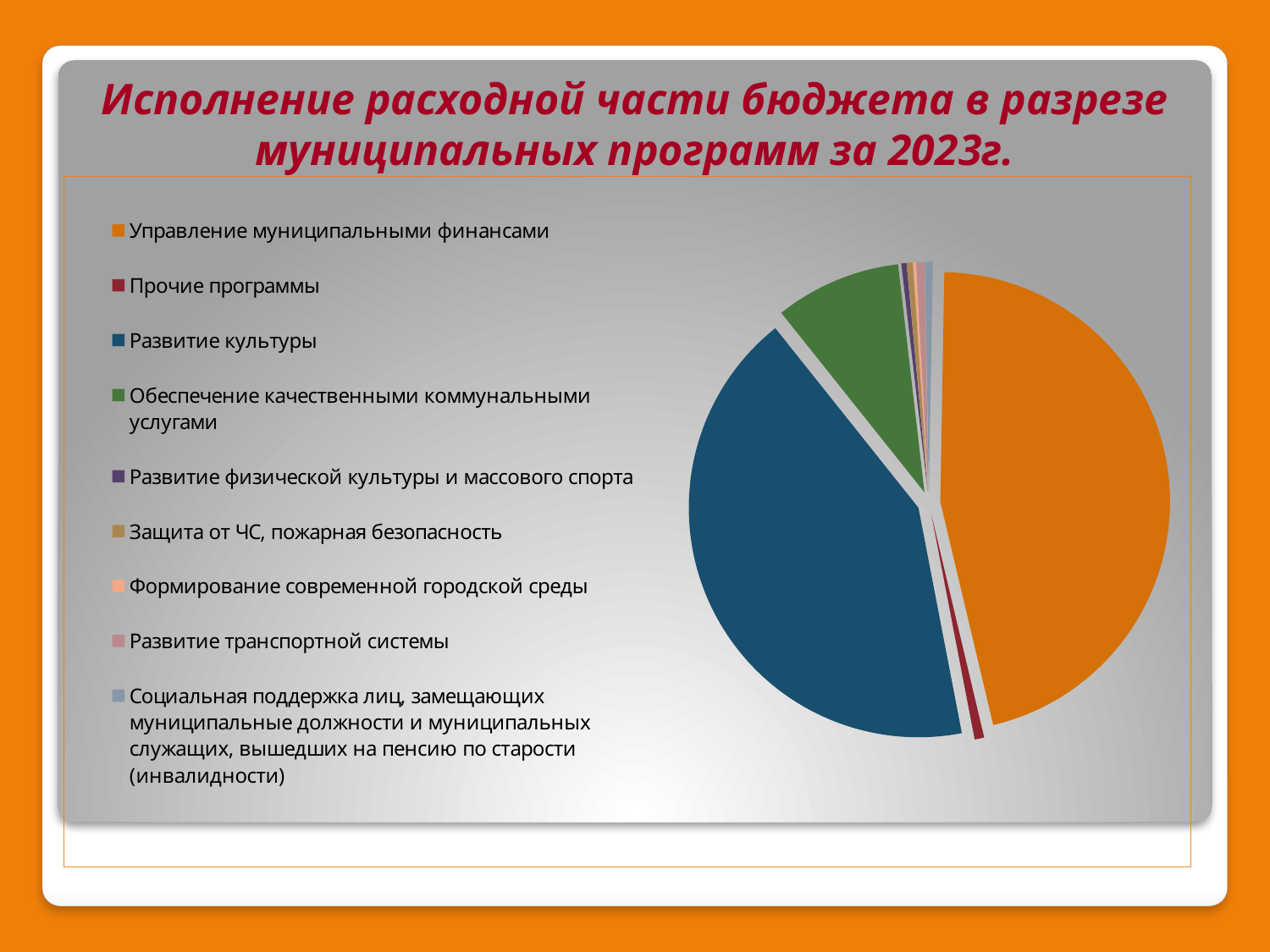
What colour is the slice for Обеспечение качественными коммунальными услугами? green Which slice is larger: Управление муниципальными финансами or Развитие культуры? Управление муниципальными финансами Which slice is larger: Развитие культуры or Обеспечение качественными коммунальными услугами? Развитие культуры Which slice is larger: Обеспечение качественными коммунальными услугами or Прочие программы? Обеспечение качественными коммунальными услугами What kind of chart is shown on the slide? pie chart What colour is the slice for Развитие культуры? blue How many categories does the pie chart's legend list? 9 Which category has the largest slice of the pie chart? Управление муниципальными финансами Which category is the second-largest slice of the pie chart? Развитие культуры